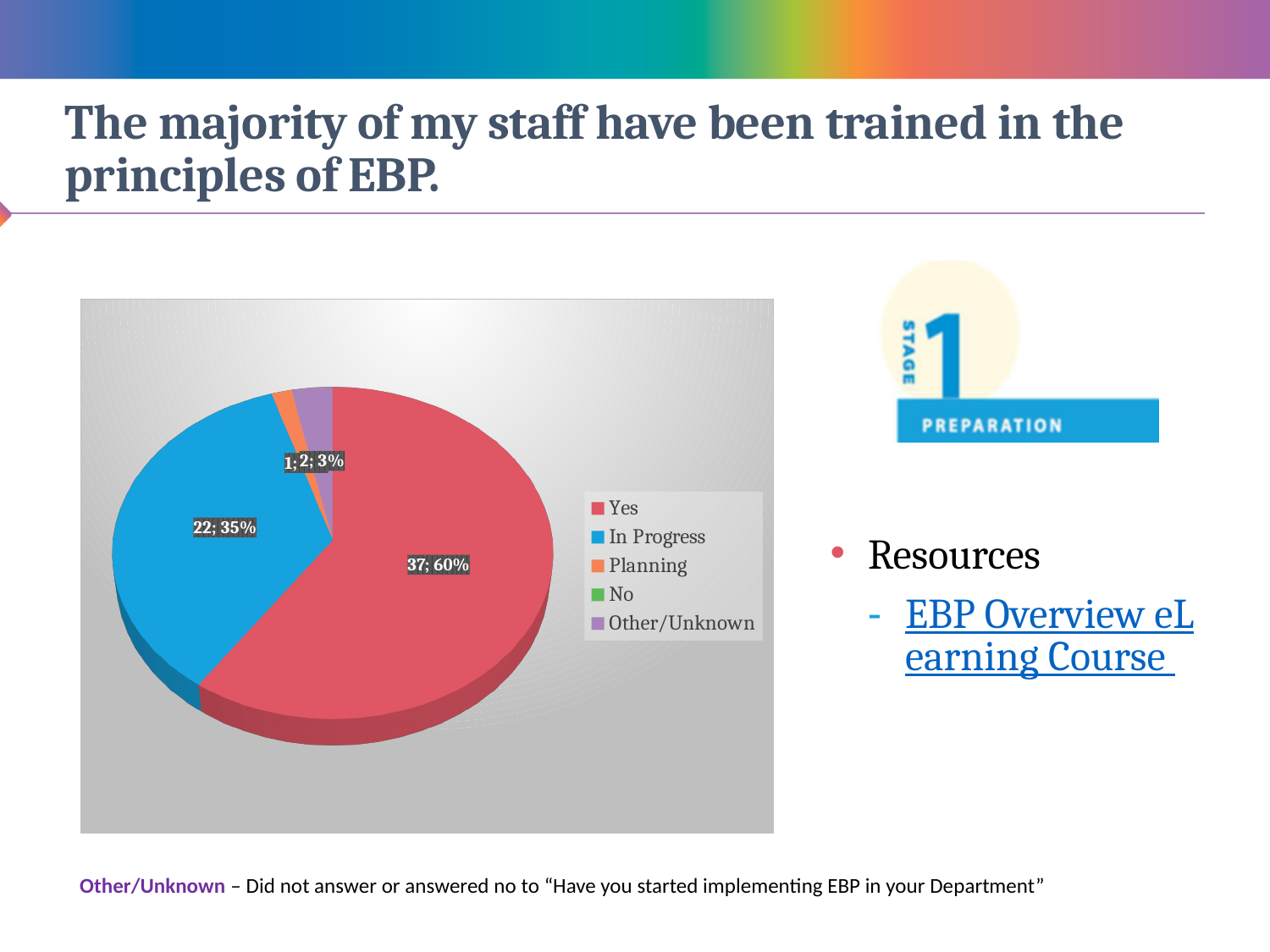
What share of the pie is the "In Progress" slice? 35% What is the difference between the number of "Yes" responses and "In Progress" responses? 15 What colour is the "In Progress" slice in the pie chart? blue What percentage of the pie does the "Yes" slice represent? 60% What kind of chart is shown on the slide? pie chart How many categories does the legend of the pie chart list? 5 Which category has the largest slice of the pie? Yes Which is larger, the "Yes" slice or the "In Progress" slice? Yes How many respondents are in the "In Progress" category? 22 What colour is the "Yes" slice in the pie chart? red How many respondents answered "Yes" according to the pie chart? 37